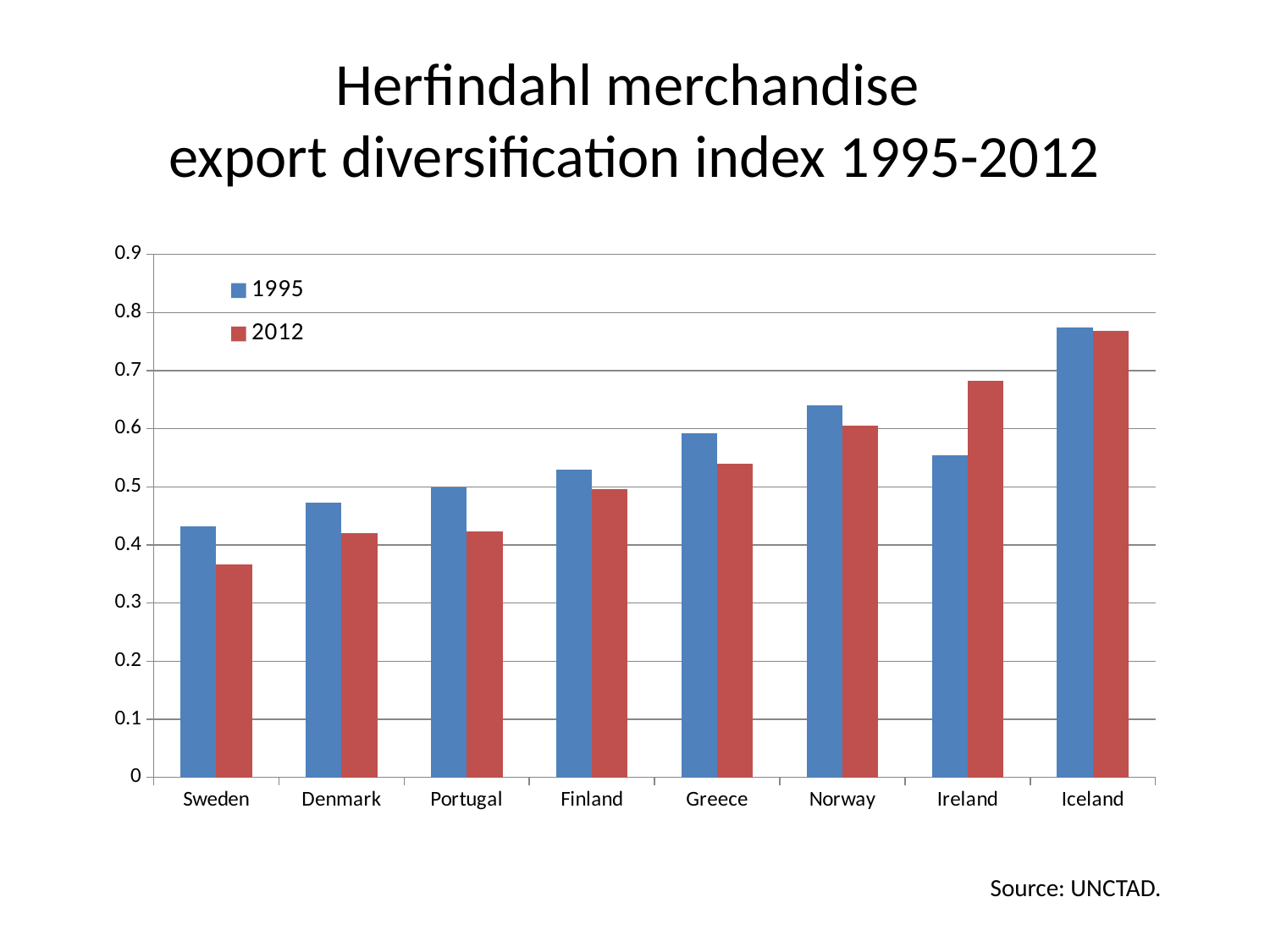
Is the 1995 value for Iceland greater or less than 0.7? greater Which is larger: the 1995 value for Norway or the 1995 value for Ireland? Norway Which country has the highest 1995 value? Iceland Is the 2012 value for Ireland greater or less than 0.6? greater Which country has the lowest 1995 value? Sweden Is the 2012 value for Sweden greater or less than 0.4? less How many series does the legend list? 2 What kind of chart is shown on the slide? Bar chart For Ireland, which is larger: the 1995 value or the 2012 value? 2012 Which country has the lowest 2012 value? Sweden How many countries are shown on the x axis? 8 What are the two series listed in the legend? 1995 and 2012